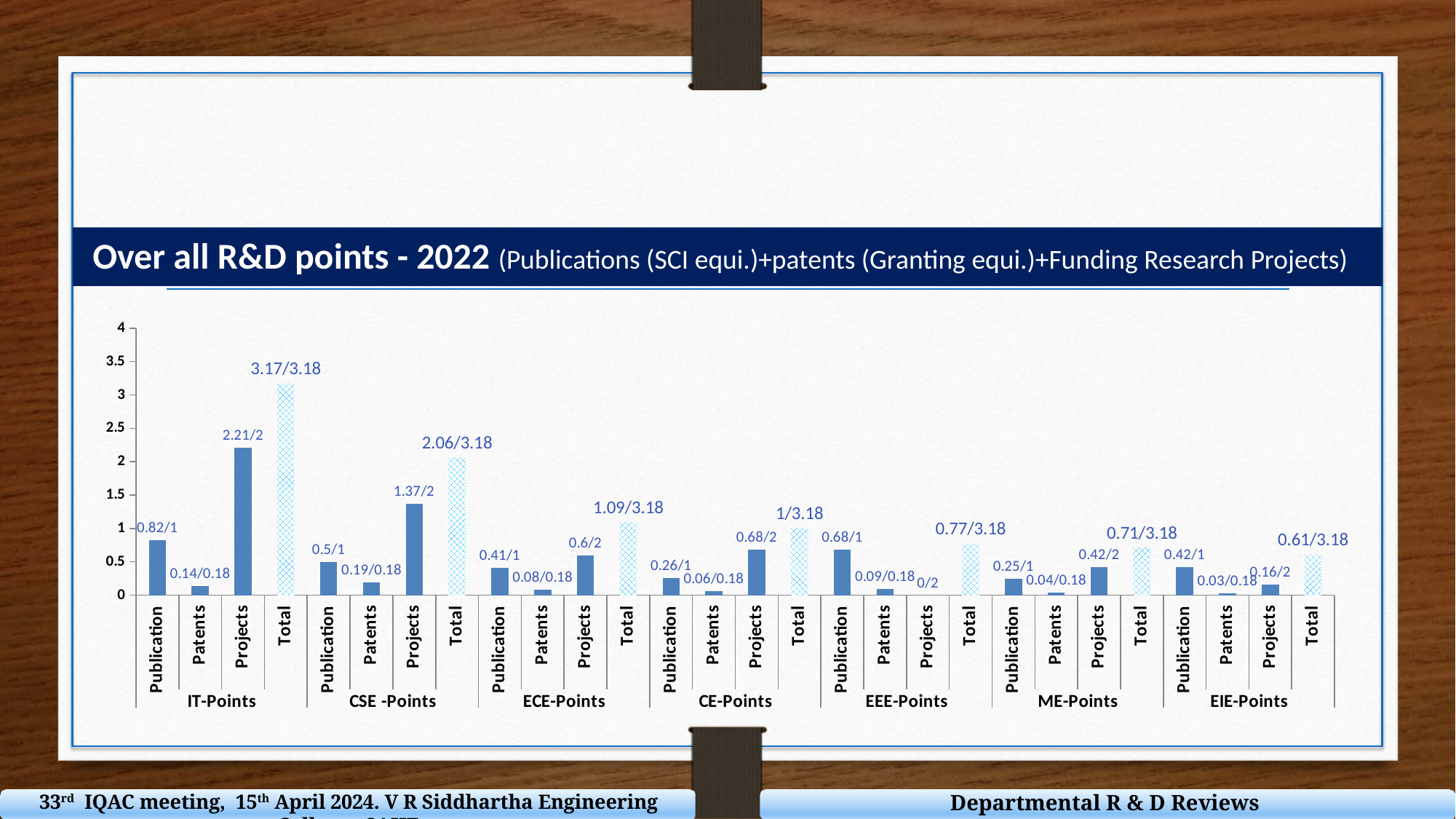
What kind of chart is shown on the slide? Bar chart What is the data label on the Total bar for IT-Points? 3.17/3.18 By how much does the IT-Points Total (3.17) exceed the CSE -Points Total (2.06)? 1.11 What is the data label on the Projects bar for CSE -Points? 1.37/2 Which department has the highest Projects bar? IT-Points How many departments are shown along the x axis? 7 Which department has the lowest Total bar? EIE-Points What is the data label on the Projects bar for EEE-Points? 0/2 Which is larger, the Publication value for CSE -Points or the Publication value for ECE-Points? CSE -Points What is the data label on the Patents bar for ME-Points? 0.04/0.18 Which department has the highest Total bar? IT-Points Is the Projects value for IT-Points greater or less than 2? greater